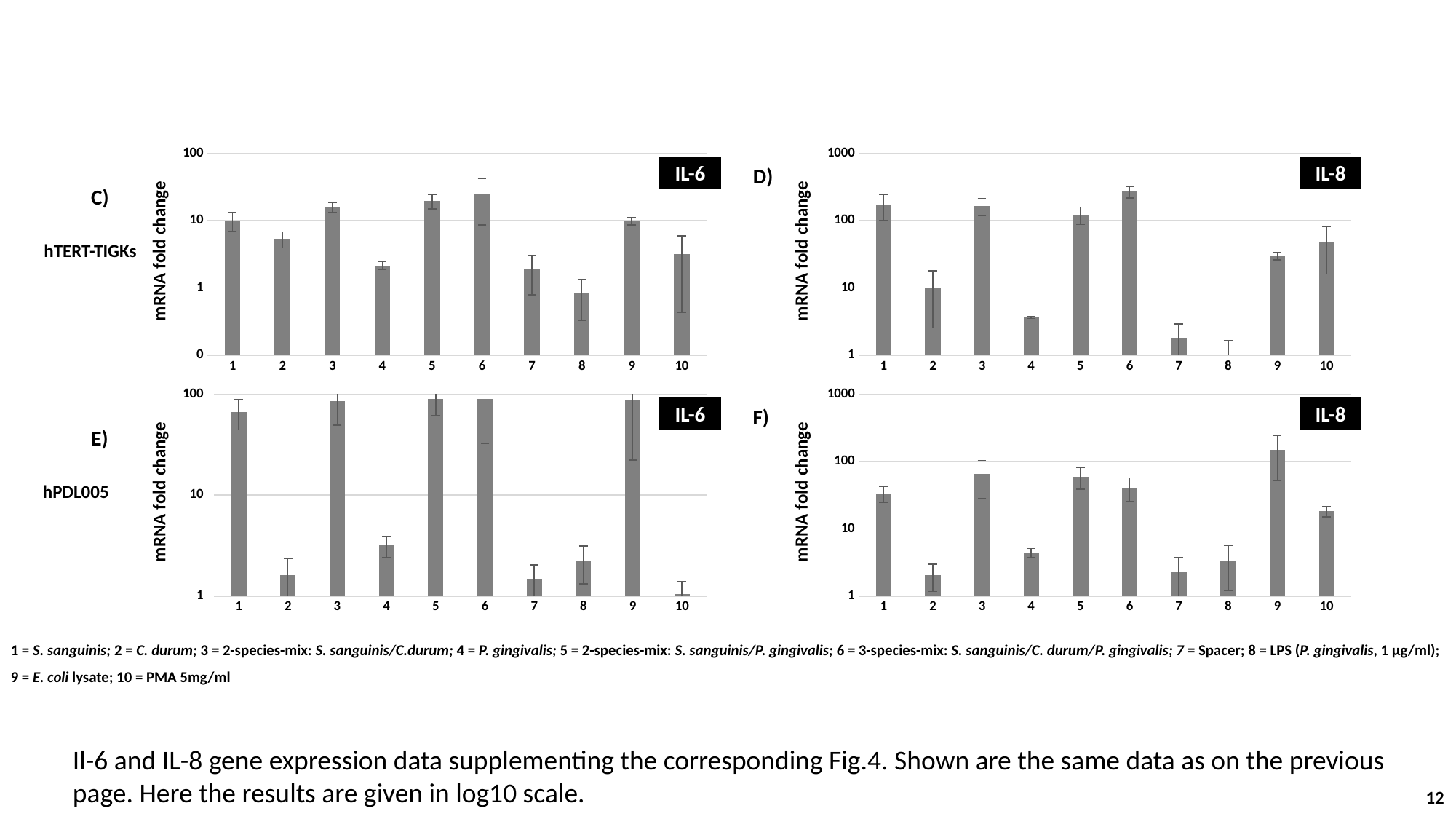
In chart F (hPDL005, IL-8), which category has the highest mRNA fold change? 9 In chart C (hTERT-TIGKs, IL-6), which category has the highest mRNA fold change? 6 What kind of chart is chart C (hTERT-TIGKs, IL-6)? bar chart In chart C (hTERT-TIGKs, IL-6), which category has the lowest mRNA fold change? 8 In chart E (hPDL005, IL-6), is the value for category 1 greater or less than 10? greater In chart E (hPDL005, IL-6), which category has the lowest mRNA fold change? 10 What is the y-axis label of chart F (hPDL005, IL-8)? mRNA fold change In chart D (hTERT-TIGKs, IL-8), is the value for category 4 greater or less than 10? less In chart D (hTERT-TIGKs, IL-8), which category has the highest mRNA fold change? 6 In chart D (hTERT-TIGKs, IL-8), which is larger, the value for category 1 or the value for category 9? category 1 How many categories are plotted on the x axis of chart D (hTERT-TIGKs, IL-8)? 10 In chart C (hTERT-TIGKs, IL-6), is the value for category 3 greater or less than 10? greater